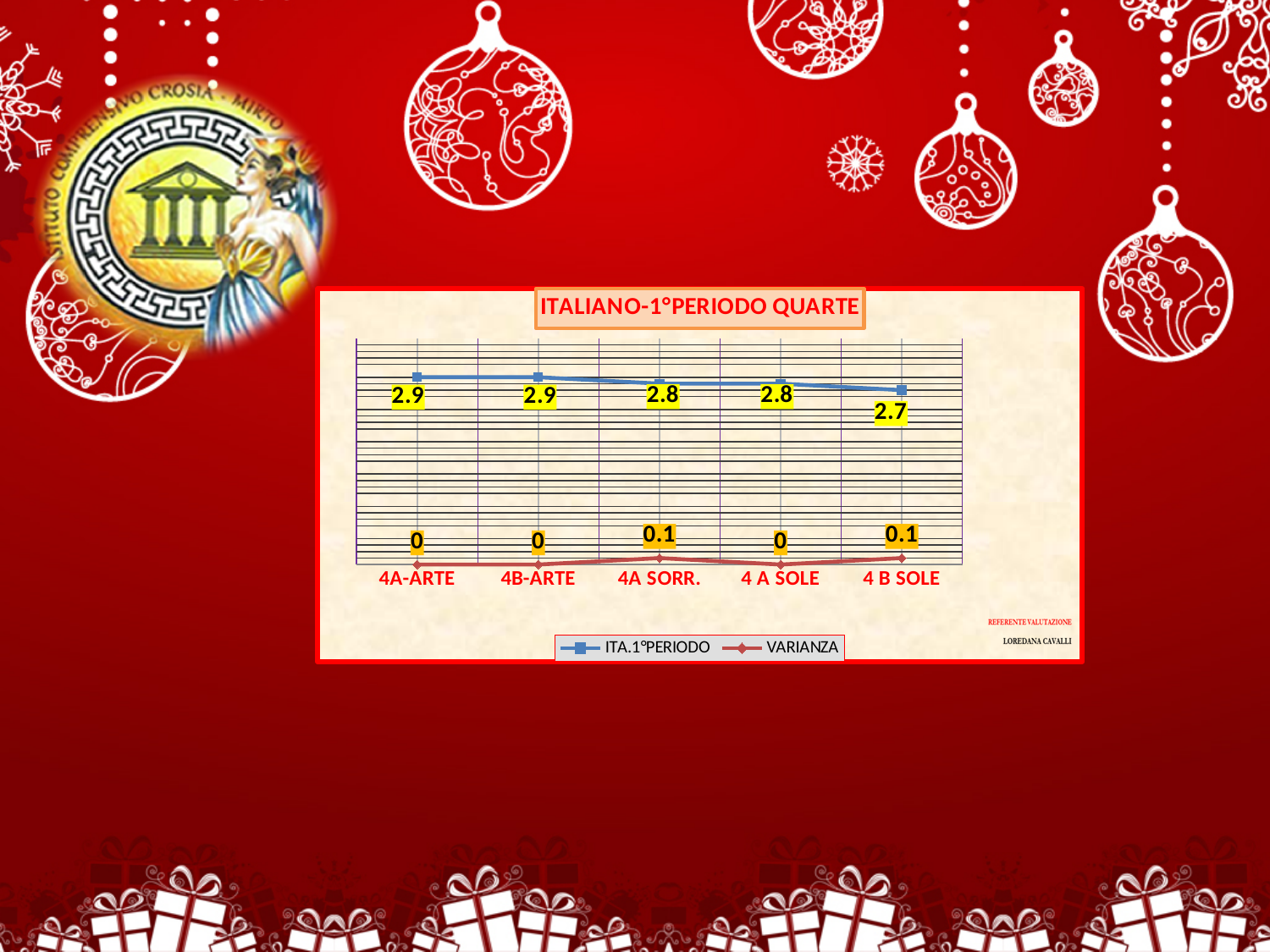
What is the VARIANZA value for 4 A SOLE? 0 How many series does the legend list? 2 What is the difference between the ITA.1°PERIODO values for 4A-ARTE and 4 B SOLE? 0.2 Which category has the lowest ITA.1°PERIODO value? 4 B SOLE How many categories are shown on the x axis? 5 What is the ITA.1°PERIODO value for 4A-ARTE? 2.9 What kind of chart is shown? Line chart What is the ITA.1°PERIODO value for 4 B SOLE? 2.7 Does the ITA.1°PERIODO series rise or fall from 4A-ARTE to 4 B SOLE? Fall What is the VARIANZA value for 4A SORR.? 0.1 What is the title of the chart? ITALIANO-1°PERIODO QUARTE Which is larger, the ITA.1°PERIODO value for 4B-ARTE or for 4A SORR.? 4B-ARTE